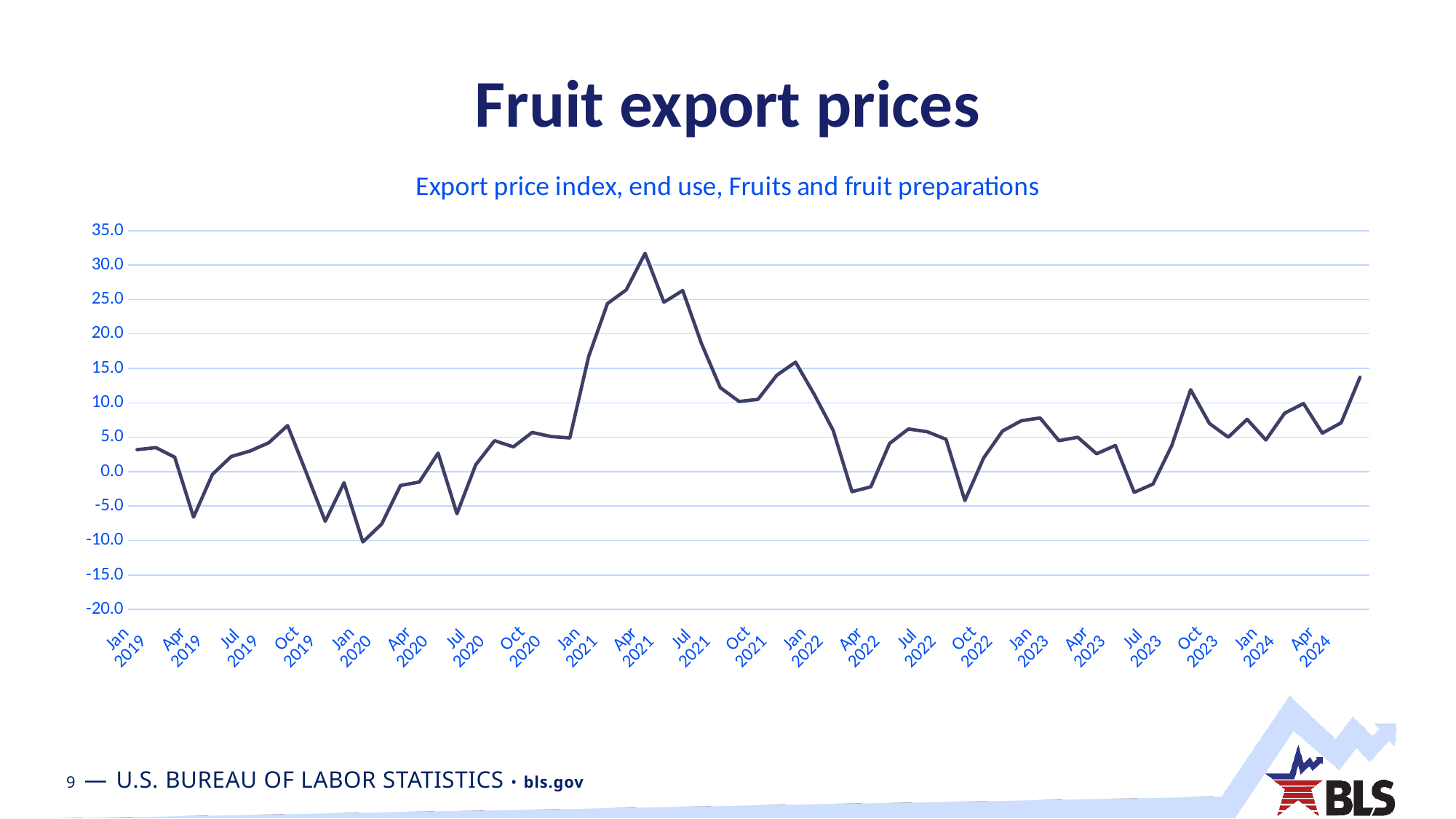
Is the value for Jan 2022 greater or less than 10.0? greater What kind of chart is shown on the slide? line chart Does the line rise or fall between Jan 2021 and Apr 2021? rise Is the value for Jan 2020 greater or less than -5.0? less Which is larger, the value for Apr 2021 or the value for Jan 2022? Apr 2021 What is the title of the chart on the slide? Fruit export prices In which month does the line reach its lowest value? Jan 2020 Is the value for Apr 2021 greater or less than 30.0? greater What is the subtitle printed above the chart? Export price index, end use, Fruits and fruit preparations In which month does the line reach its highest value? Apr 2021 Does the line rise or fall between Apr 2021 and Oct 2021? fall